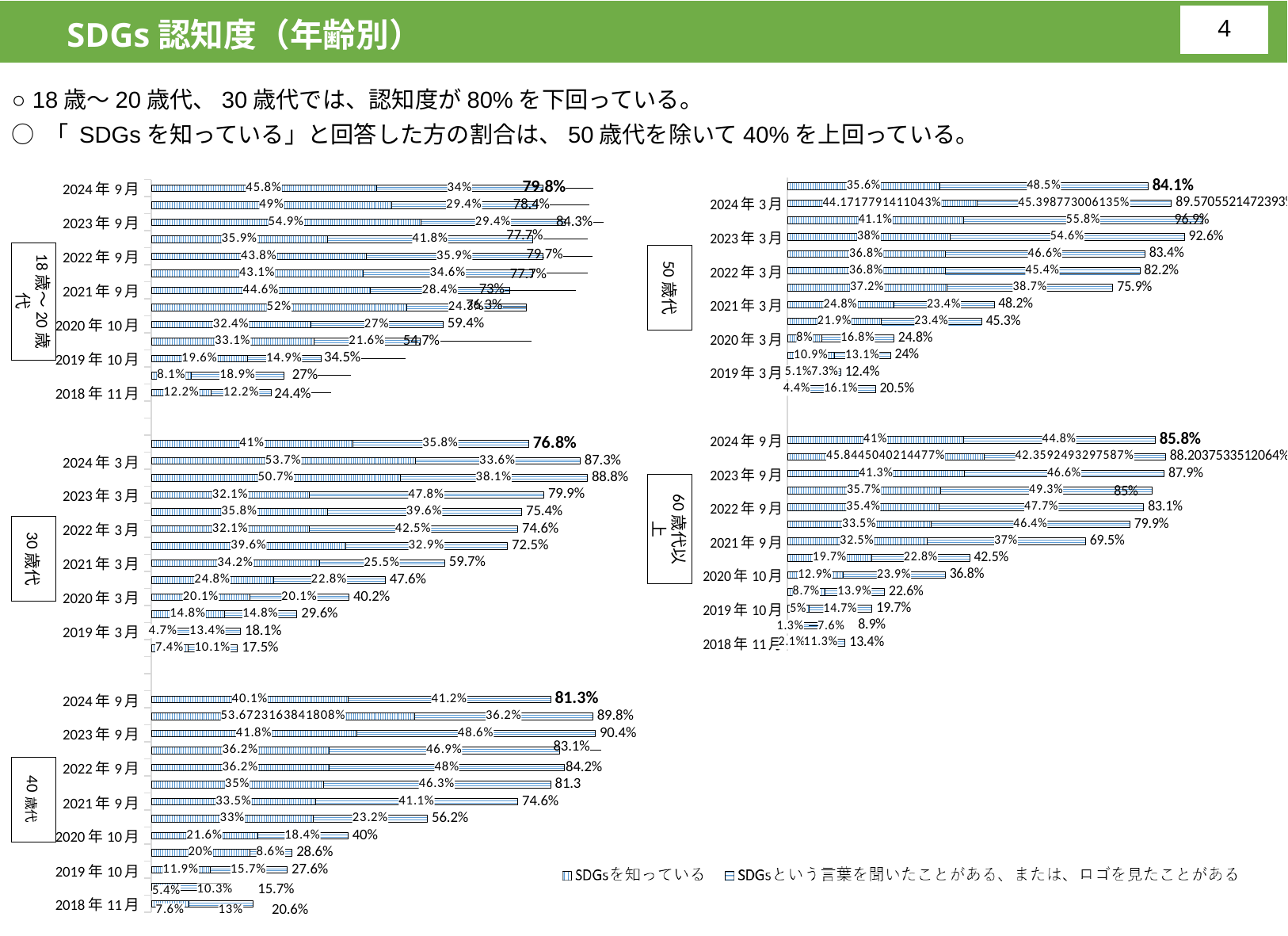
In the 30歳代 chart, what is the total shown for the bottom bar? 17.5% In the 40歳代 chart, do the bar totals generally rise or fall from the bottom (2018年11月) to the top (2024年9月)? rise How many bars are plotted in the 18歳～20歳代 chart? 13 In the 30歳代 chart, for the topmost bar (2024年3月), which segment is larger: SDGsを知っている or SDGsという言葉を聞いたことがある、または、ロゴを見たことがある? SDGsを知っている In the 60歳代以上 chart, what is the smallest total shown on any bar? 8.9% What kind of chart is the 18歳～20歳代 chart? bar chart In the 40歳代 chart, what is the difference between the two segments of the topmost bar (41.2% and 40.1%)? 1.1 percentage points How many series does the legend list? 2 In the 18歳～20歳代 chart, what is the SDGsを知っている value for the topmost bar (2024年9月)? 45.8% In the 18歳～20歳代 chart, what is the total shown for the bottom bar (2018年11月)? 24.4% In the 60歳代以上 chart, what is the total shown for the topmost bar (2024年9月)? 85.8%